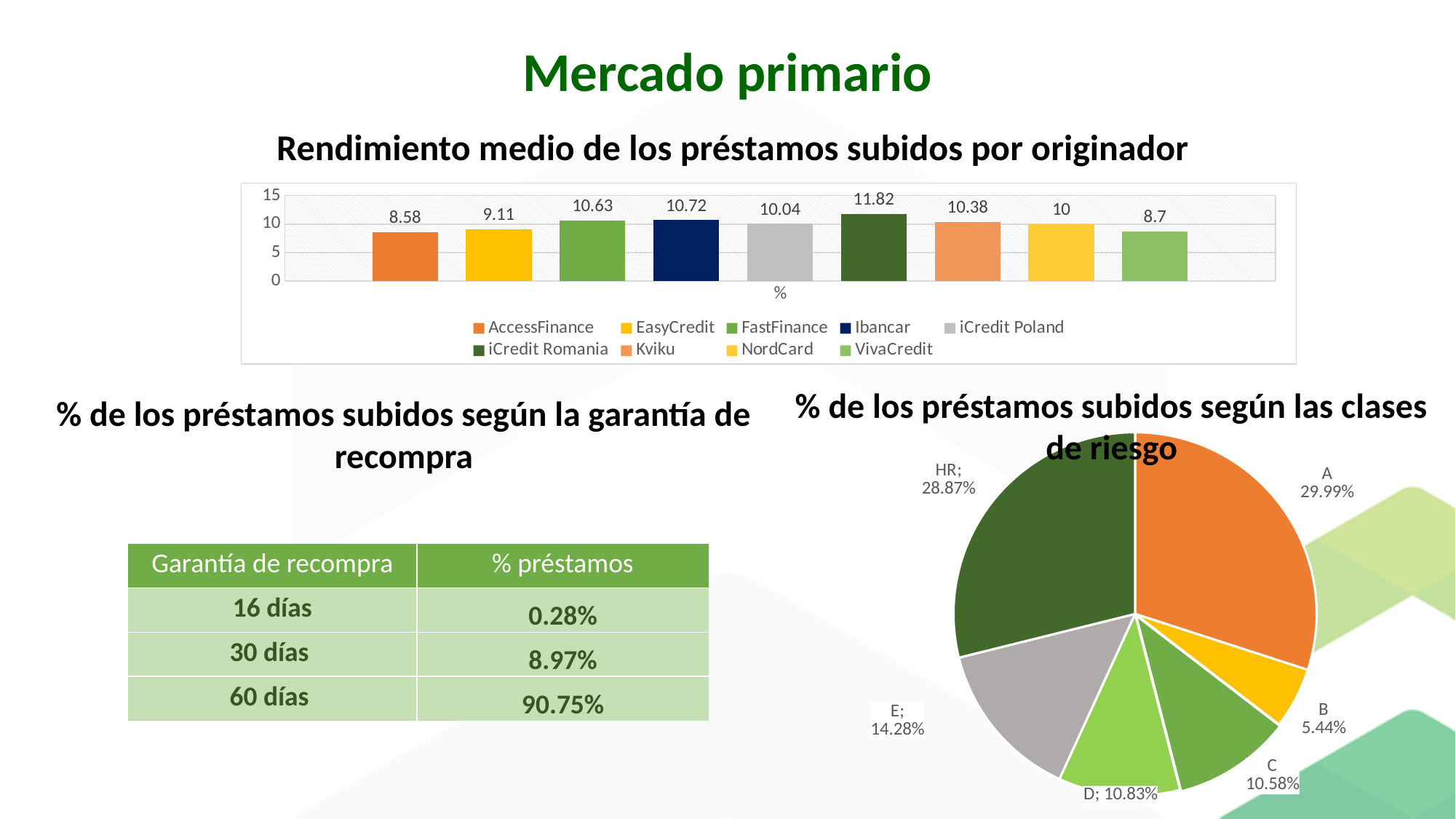
In the bar chart 'Rendimiento medio de los préstamos subidos por originador', which originator has the lowest value? AccessFinance In the pie chart '% de los préstamos subidos según las clases de riesgo', what is the difference between the shares of E and C? 3.70% In the bar chart 'Rendimiento medio de los préstamos subidos por originador', which is larger, the value for FastFinance or the value for VivaCredit? FastFinance How many slices does the pie chart '% de los préstamos subidos según las clases de riesgo' have? 6 In the bar chart 'Rendimiento medio de los préstamos subidos por originador', what is the value for iCredit Romania? 11.82 What kind of chart is 'Rendimiento medio de los préstamos subidos por originador'? Bar chart In the bar chart 'Rendimiento medio de los préstamos subidos por originador', what is the value for Kviku? 10.38 In the pie chart '% de los préstamos subidos según las clases de riesgo', which risk class has the smallest slice? B In the bar chart 'Rendimiento medio de los préstamos subidos por originador', which originator has the highest value? iCredit Romania In the pie chart '% de los préstamos subidos según las clases de riesgo', what share does class A have? 29.99% In the bar chart 'Rendimiento medio de los préstamos subidos por originador', what is the difference between the values for Ibancar and EasyCredit? 1.61 How many originators are shown in the bar chart 'Rendimiento medio de los préstamos subidos por originador'? 9